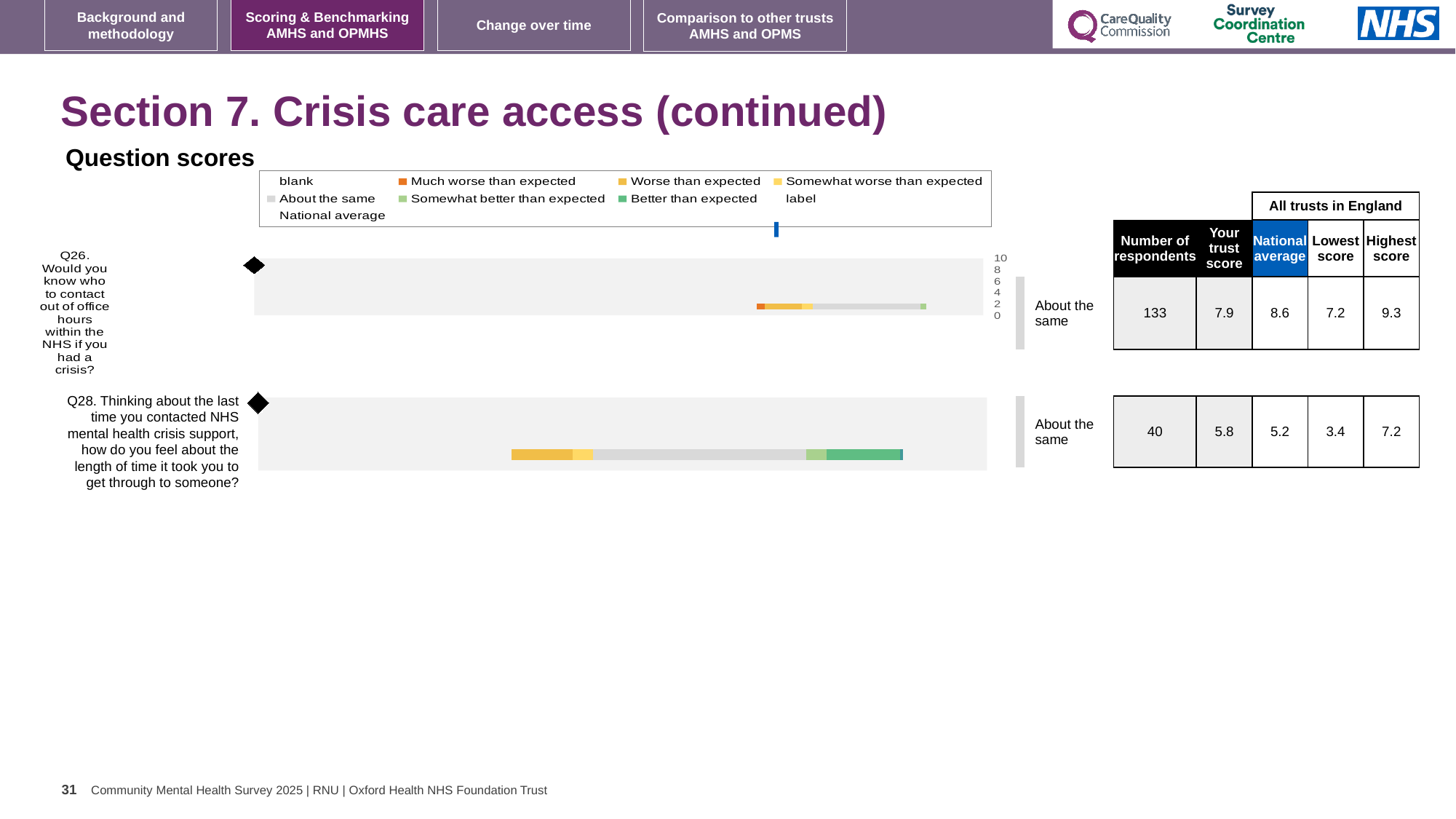
For Q28, which is larger: the trust score or the national average? trust score What is the difference between the highest and lowest scores for Q26? 2.1 What is the trust score for Q26 (knowing who to contact out of office hours in a crisis)? 7.9 How many respondents answered Q26? 133 What is the lowest score among all trusts in England for Q28? 3.4 What benchmark category is shown next to the Q26 bar? About the same How many questions are plotted in the question scores chart? 2 Which question has the higher trust score, Q26 or Q28? Q26 What is the difference between the highest and lowest scores for Q28? 3.8 For Q26, which is larger: the trust score or the national average? national average What kind of chart is used to show the question scores for Q26 and Q28? bar chart What is the national average score for Q28 (length of time to get through to crisis support)? 5.2